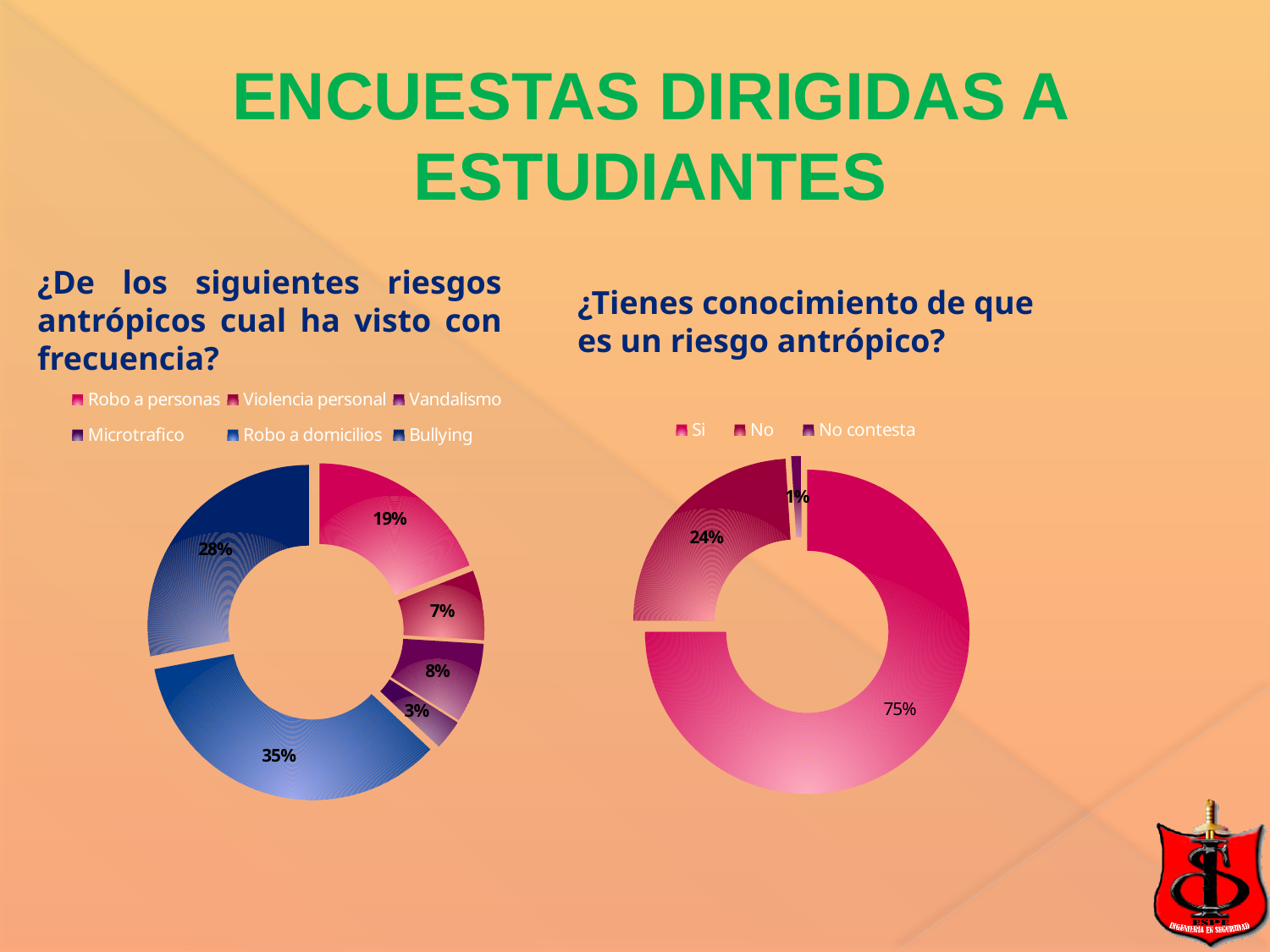
In the left chart (¿De los siguientes riesgos antrópicos cual ha visto con frecuencia?), what percentage is shown for Bullying? 28% What type of chart is the right chart (¿Tienes conocimiento de que es un riesgo antrópico?)? Doughnut chart In the right chart (¿Tienes conocimiento de que es un riesgo antrópico?), what percentage answered Si? 75% In the left chart (¿De los siguientes riesgos antrópicos cual ha visto con frecuencia?), what percentage is shown for Microtrafico? 3% In the left chart (¿De los siguientes riesgos antrópicos cual ha visto con frecuencia?), which category has the largest share? Robo a domicilios In the right chart (¿Tienes conocimiento de que es un riesgo antrópico?), what percentage answered No? 24% In the right chart (¿Tienes conocimiento de que es un riesgo antrópico?), which response has the smallest share? No contesta In the left chart (¿De los siguientes riesgos antrópicos cual ha visto con frecuencia?), which category has the smallest share? Microtrafico In the left chart (¿De los siguientes riesgos antrópicos cual ha visto con frecuencia?), which is larger, Robo a personas or Vandalismo? Robo a personas In the left chart (¿De los siguientes riesgos antrópicos cual ha visto con frecuencia?), what percentage is shown for Robo a domicilios? 35% How many categories does the legend of the left chart (¿De los siguientes riesgos antrópicos cual ha visto con frecuencia?) list? 6 In the left chart (¿De los siguientes riesgos antrópicos cual ha visto con frecuencia?), what is the difference in percentage points between Robo a domicilios and Bullying? 7